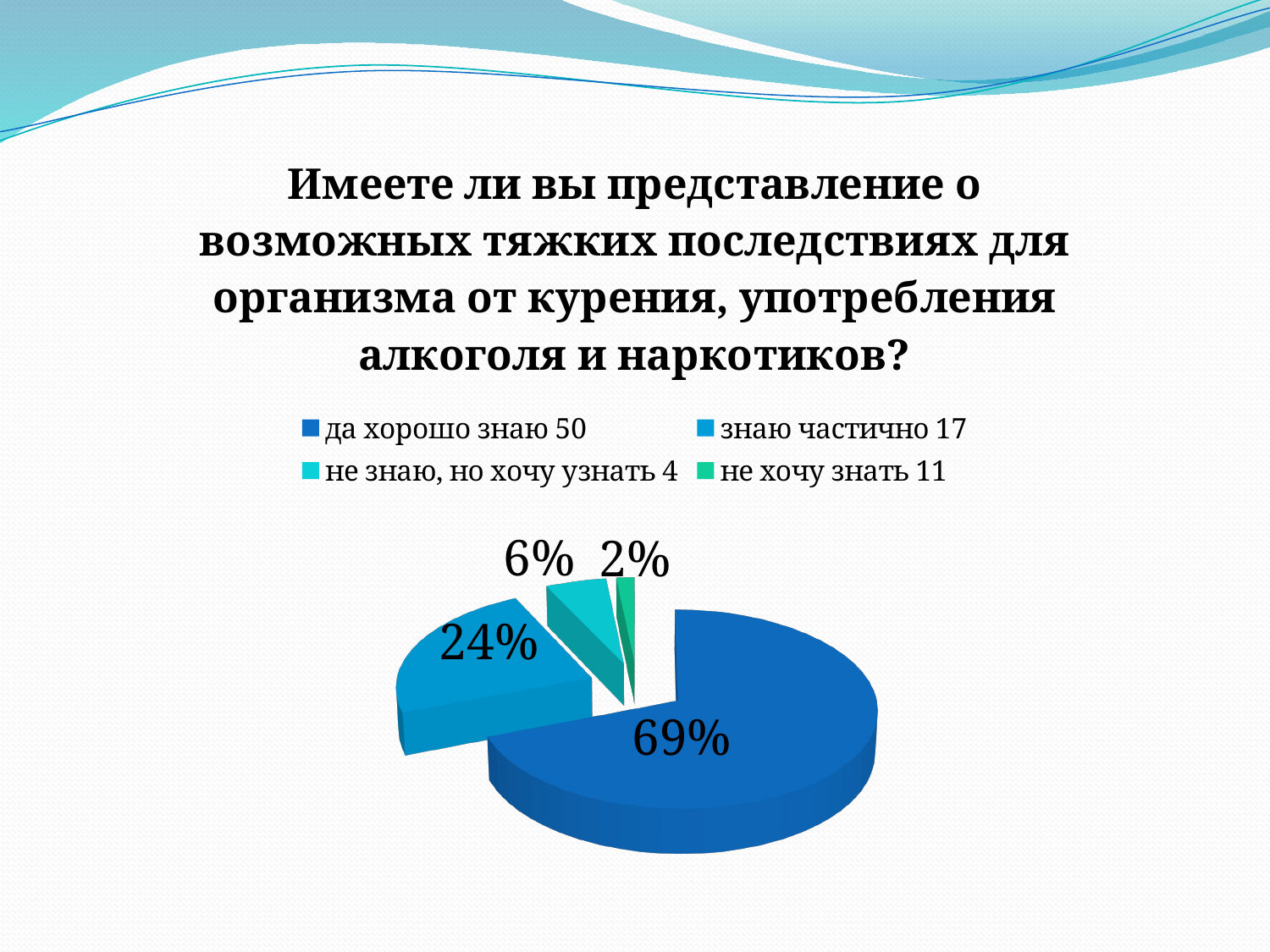
What share of the pie does the slice for "не хочу знать" take? 2% Which category has the smallest slice of the pie? не хочу знать What share of the pie does the slice for "да хорошо знаю" take? 69% How many entries does the legend list? 4 Which slice is larger: "знаю частично" or "не знаю, но хочу узнать"? знаю частично Which category has the largest slice of the pie? да хорошо знаю How many slices does the pie chart have? 4 What share of the pie does the slice for "знаю частично" take? 24% What kind of chart is shown on the slide? pie chart What is the difference in percentage points between the "да хорошо знаю" slice and the "знаю частично" slice? 45 What number appears next to "знаю частично" in the legend? 17